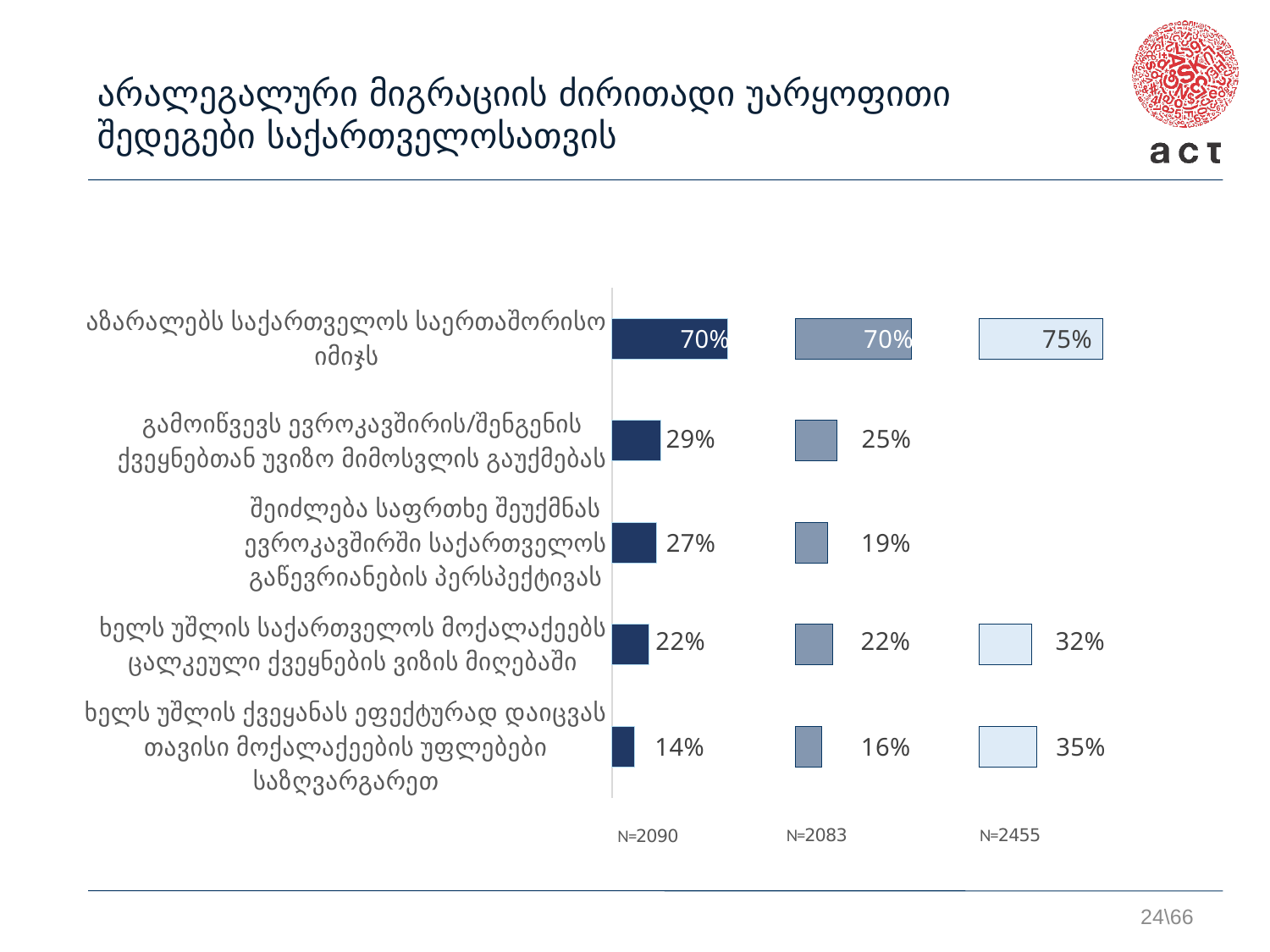
What kind of chart is shown on the slide? bar chart How many series (N groups) are shown on the chart? 3 For 'შეიძლება საფრთხე შეუქმნას ევროკავშირში საქართველოს გაწევრიანების პერსპექტივას', which series has the larger value, N=2090 or N=2083? N=2090 What is the value for 'შეიძლება საფრთხე შეუქმნას ევროკავშირში საქართველოს გაწევრიანების პერსპექტივას' in the N=2083 series? 19% What is the value for 'გამოიწვევს ევროკავშირის/შენგენის ქვეყნებთან უვიზო მიმოსვლის გაუქმებას' in the N=2090 series? 29% What is the value for 'აზარალებს საქართველოს საერთაშორისო იმიჯს' in the N=2455 series? 75% What is the difference between the N=2455 and N=2090 values for 'ხელს უშლის საქართველოს მოქალაქეებს ცალკეული ქვეყნების ვიზის მიღებაში'? 10% How many categories are listed on the chart? 5 Which category has the highest value in the N=2090 series? აზარალებს საქართველოს საერთაშორისო იმიჯს What is the value for 'ხელს უშლის ქვეყანას ეფექტურად დაიცვას თავისი მოქალაქეების უფლებები საზღვარგარეთ' in the N=2455 series? 35% What is the sample size label shown under the first (dark blue) series? N=2090 Which category has the lowest value in the N=2083 series? ხელს უშლის ქვეყანას ეფექტურად დაიცვას თავისი მოქალაქეების უფლებები საზღვარგარეთ